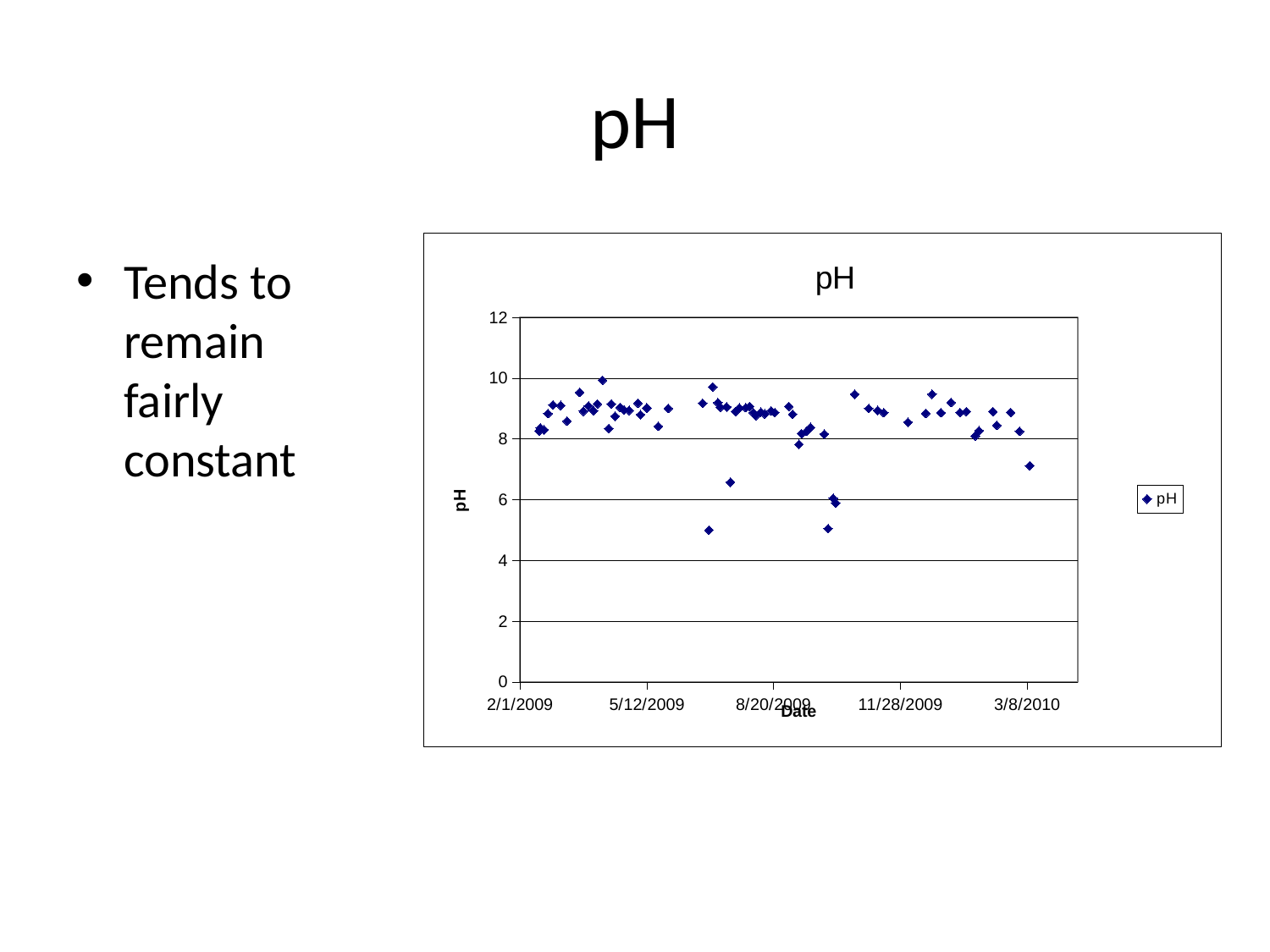
Do the pH values generally rise, fall, or stay roughly constant across the dates on the x axis? stay roughly constant How many series does the legend list? 1 Is the lowest pH value plotted greater or less than 6? less What kind of chart is shown on the slide? scatter chart What is the title of the chart? pH Is the lowest pH value plotted greater or less than 4? greater Are most of the plotted pH values greater or less than 8? greater What is the label on the x axis of the chart? Date